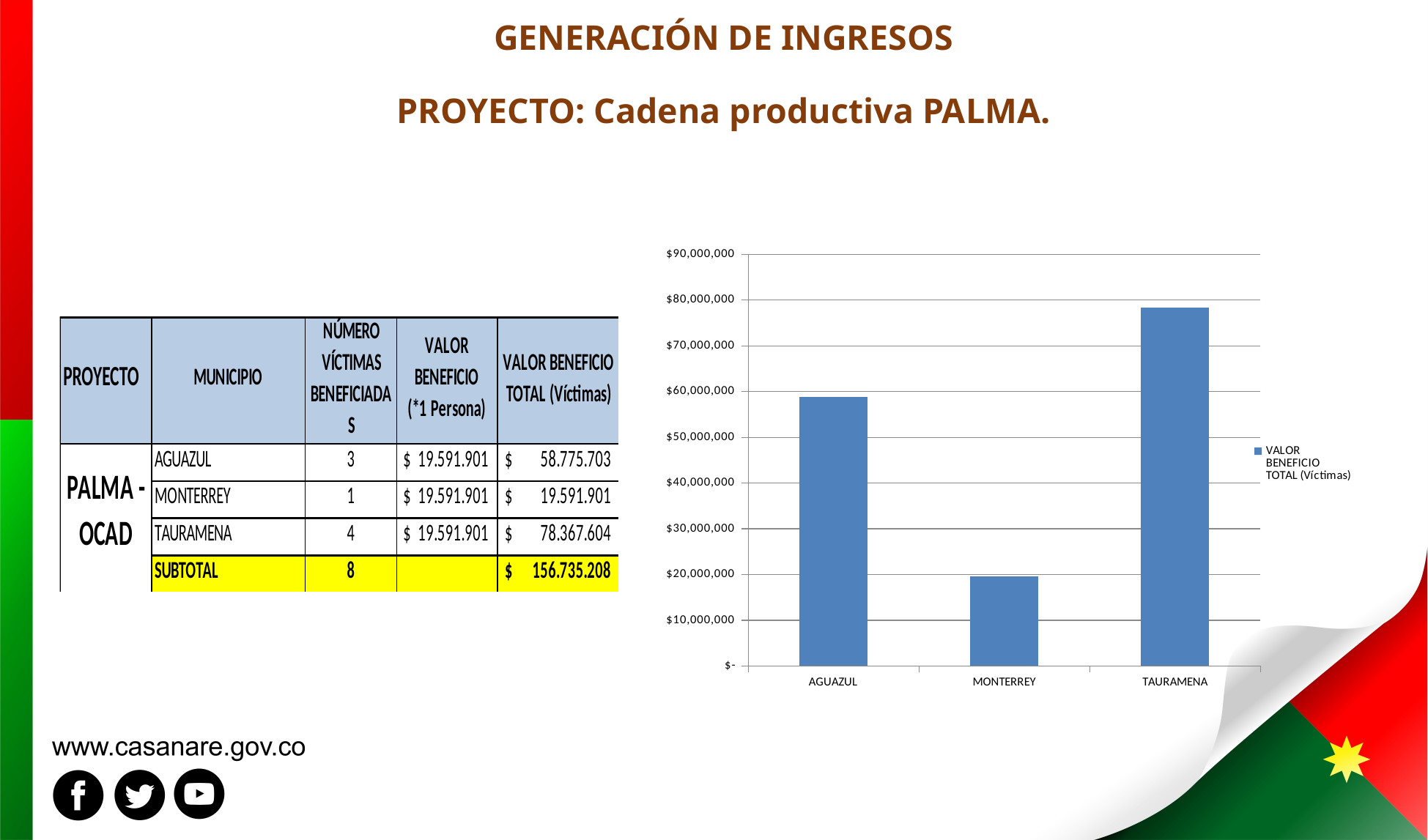
How many categories are shown on the x axis of the chart? 3 What is the highest value shown on the chart's y axis? $90,000,000 Which municipality has the lowest bar in the chart? MONTERREY Is the bar for AGUAZUL greater or less than $50,000,000? greater Is the bar for AGUAZUL greater or less than $60,000,000? less Is the bar for TAURAMENA greater or less than $70,000,000? greater What is the name of the series shown in the chart legend? VALOR BENEFICIO TOTAL (Víctimas) How many series does the chart legend list? 1 What kind of chart is shown on the slide? bar chart Which municipality has the highest bar in the chart? TAURAMENA Which bar is taller, AGUAZUL or MONTERREY? AGUAZUL